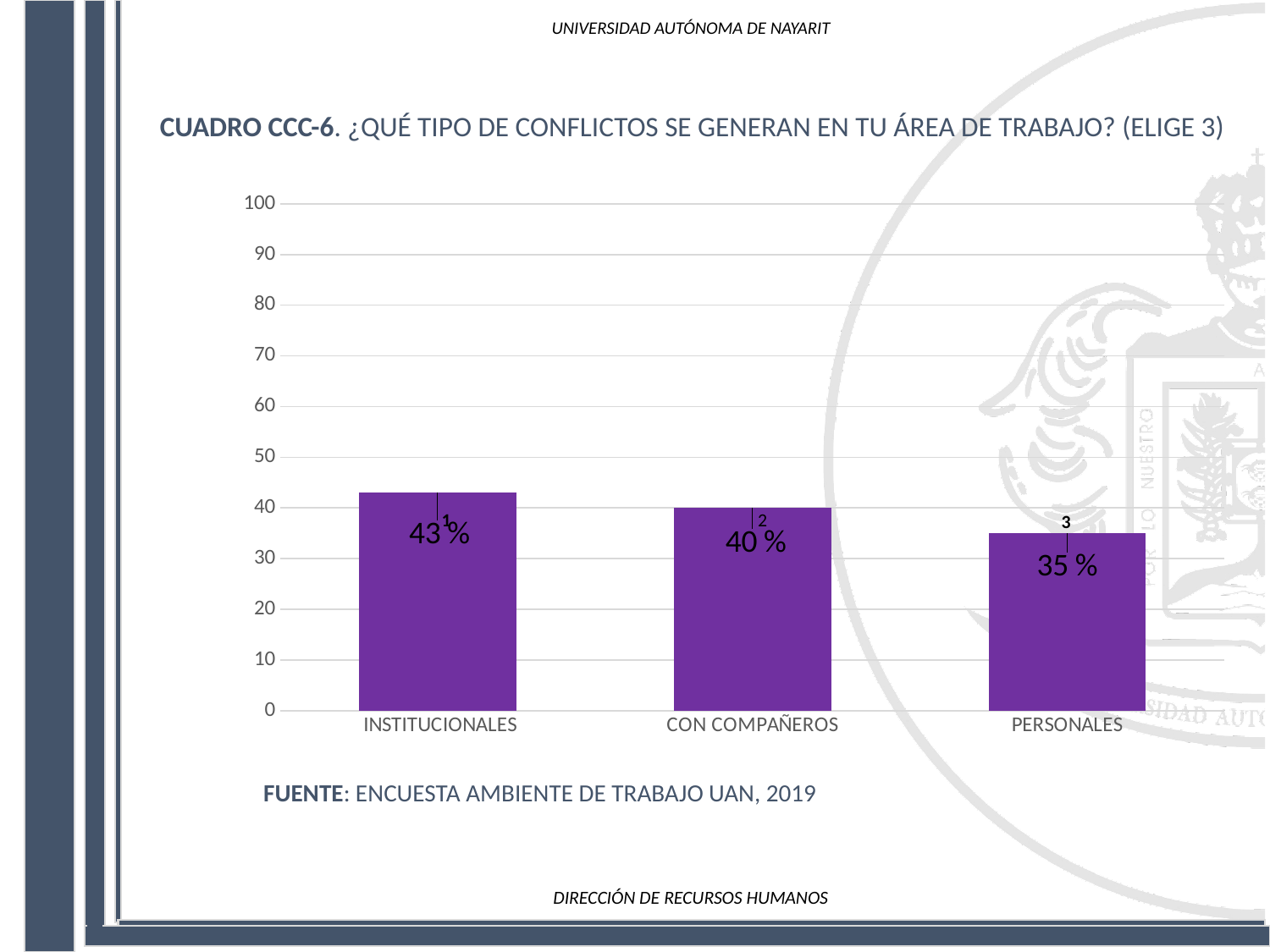
Do the values rise or fall from left to right along the x axis? fall Is the value for PERSONALES greater or less than 50? less What is the value for CON COMPAÑEROS? 40 % Which category has the lowest value? PERSONALES What kind of chart is shown on the slide? bar chart What is the difference between the values for CON COMPAÑEROS and PERSONALES? 5 % What is the difference between the values for INSTITUCIONALES and PERSONALES? 8 % How many categories are shown on the x axis? 3 What is the value for INSTITUCIONALES? 43 % What is the value for PERSONALES? 35 % Which category has the highest value? INSTITUCIONALES Which is larger, the value for INSTITUCIONALES or the value for CON COMPAÑEROS? INSTITUCIONALES